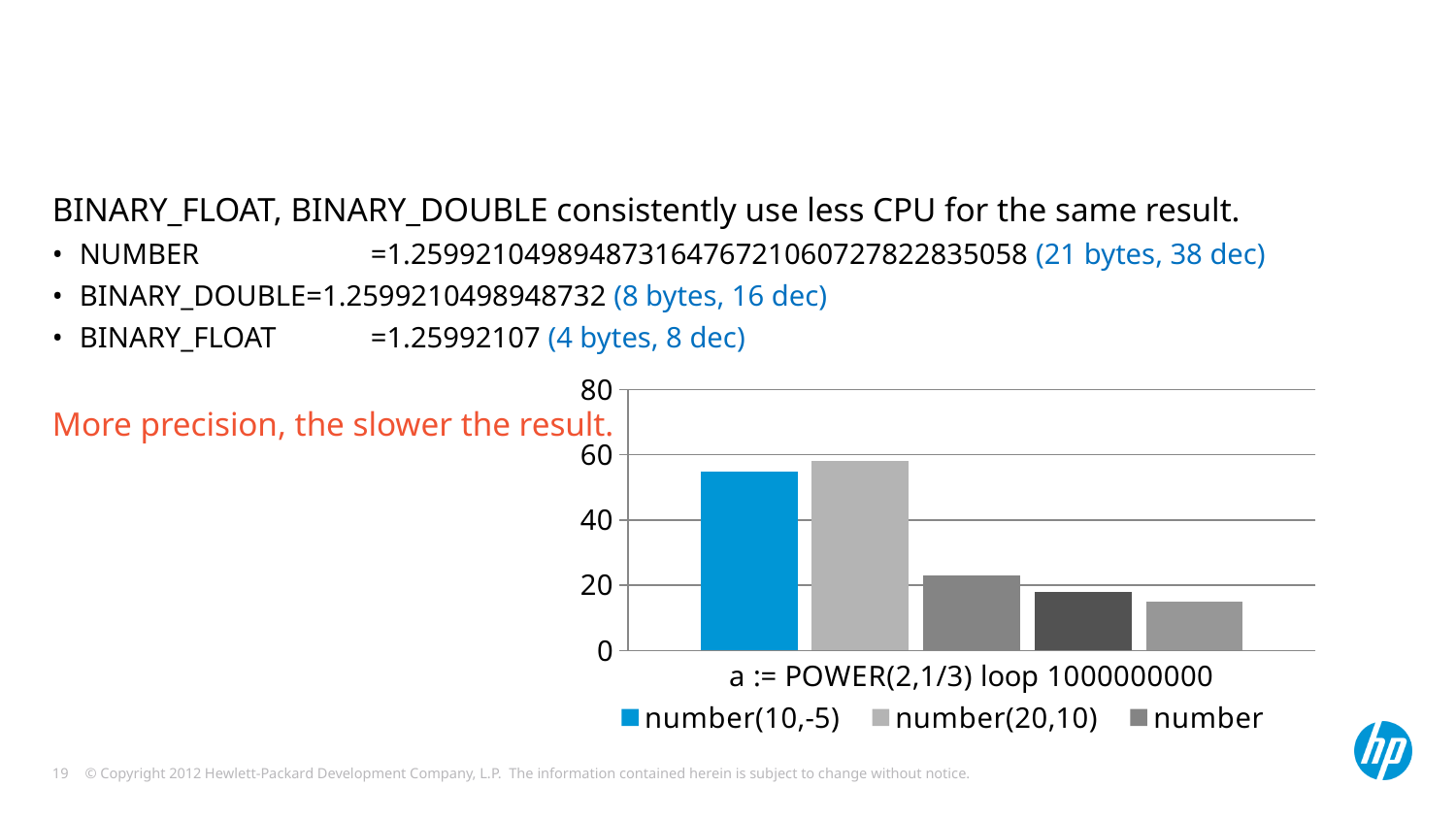
Is the value for number(20,10) greater or less than 40? greater Is the value for number(10,-5) greater or less than 60? less Which is larger, the value for number(10,-5) or the value for number? number(10,-5) What kind of chart is shown on the slide? bar chart What is the category label on the x axis of the chart? a := POWER(2,1/3) loop 1000000000 Is the value for number(10,-5) greater or less than 40? greater How many series does the chart legend list? 3 How many categories are shown on the x axis of the chart? 1 What is the highest value shown on the chart's y axis? 80 Which is larger, the value for number(20,10) or the value for number? number(20,10)